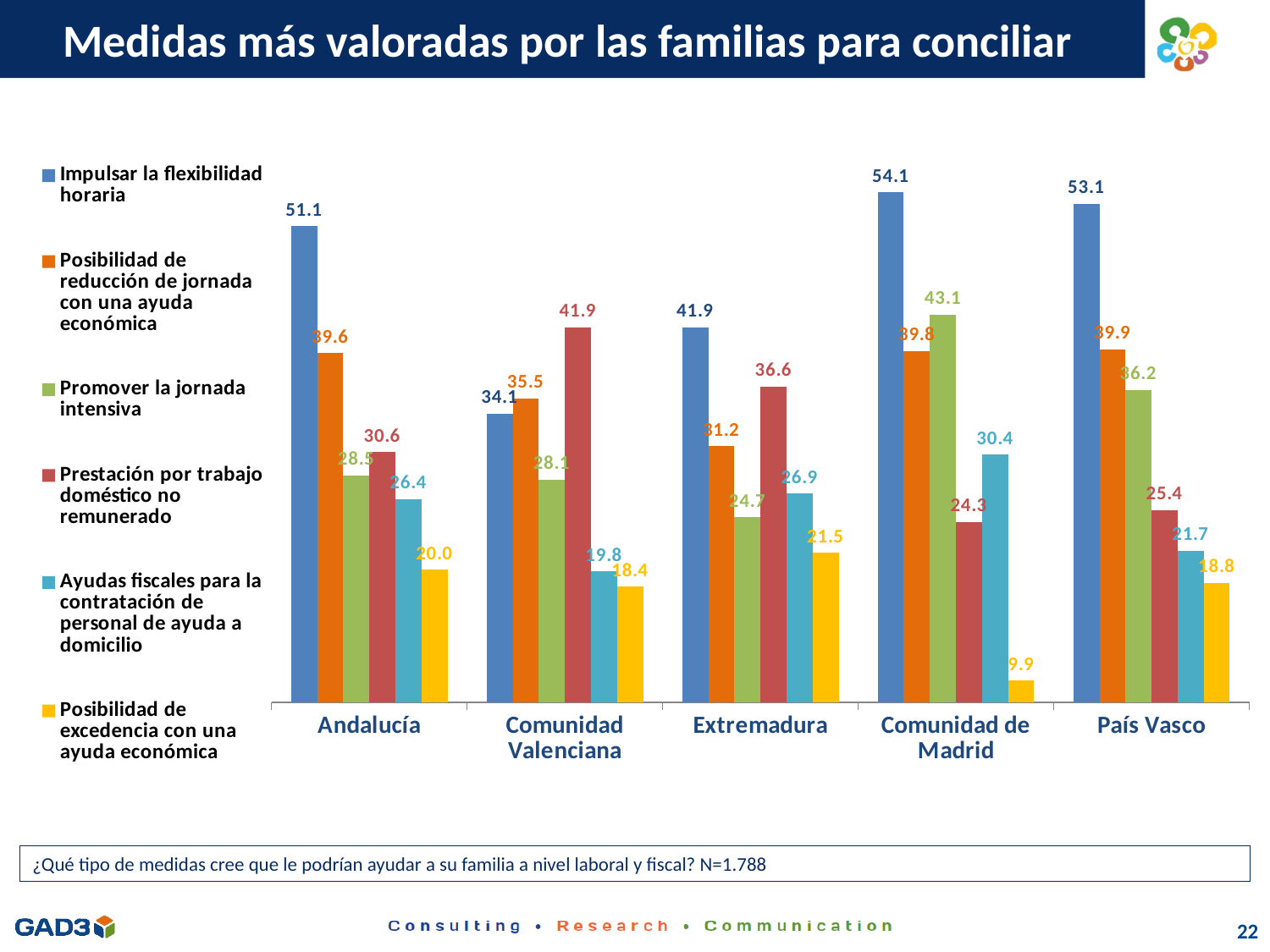
What is the value for 'Impulsar la flexibilidad horaria' in Comunidad de Madrid? 54.1 Which region has the highest value for 'Impulsar la flexibilidad horaria'? Comunidad de Madrid How many series does the legend list? 6 For 'Ayudas fiscales para la contratación de personal de ayuda a domicilio', which is larger: Comunidad de Madrid or País Vasco? Comunidad de Madrid In Comunidad de Madrid, what is the difference between 'Impulsar la flexibilidad horaria' and 'Posibilidad de excedencia con una ayuda económica'? 44.2 What kind of chart is shown on the slide? Bar chart How many regions are shown on the x axis of the chart? 5 What is the value for 'Prestación por trabajo doméstico no remunerado' in Comunidad Valenciana? 41.9 What is the value for 'Posibilidad de excedencia con una ayuda económica' in Comunidad de Madrid? 9.9 Which region has the lowest value for 'Posibilidad de excedencia con una ayuda económica'? Comunidad de Madrid What is the value for 'Promover la jornada intensiva' in Comunidad de Madrid? 43.1 What is the title of the slide? Medidas más valoradas por las familias para conciliar